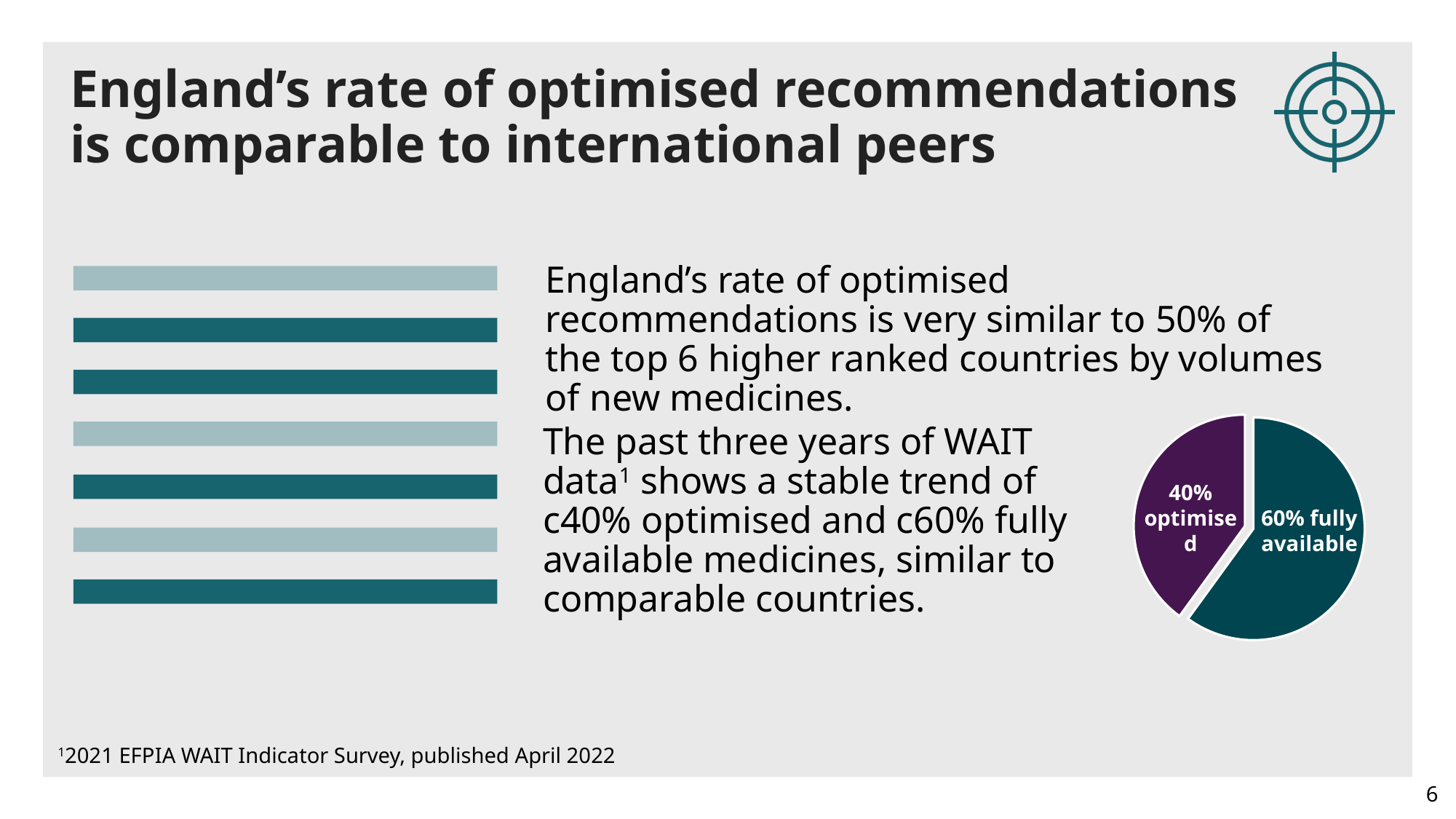
What colour is the fully available slice of the pie chart? dark teal In the pie chart, what share of medicines is labelled as fully available? 60% Which slice of the pie chart is larger, optimised or fully available? fully available What kind of chart is shown on the right side of the slide? pie chart In the pie chart, what share of medicines is labelled as optimised? 40% Which slice of the pie chart is the smallest? 40% optimised What colour is the optimised slice of the pie chart? purple Which slice of the pie chart is the largest? 60% fully available How many slices does the pie chart have? 2 What is the difference in percentage points between the fully available slice and the optimised slice in the pie chart? 20